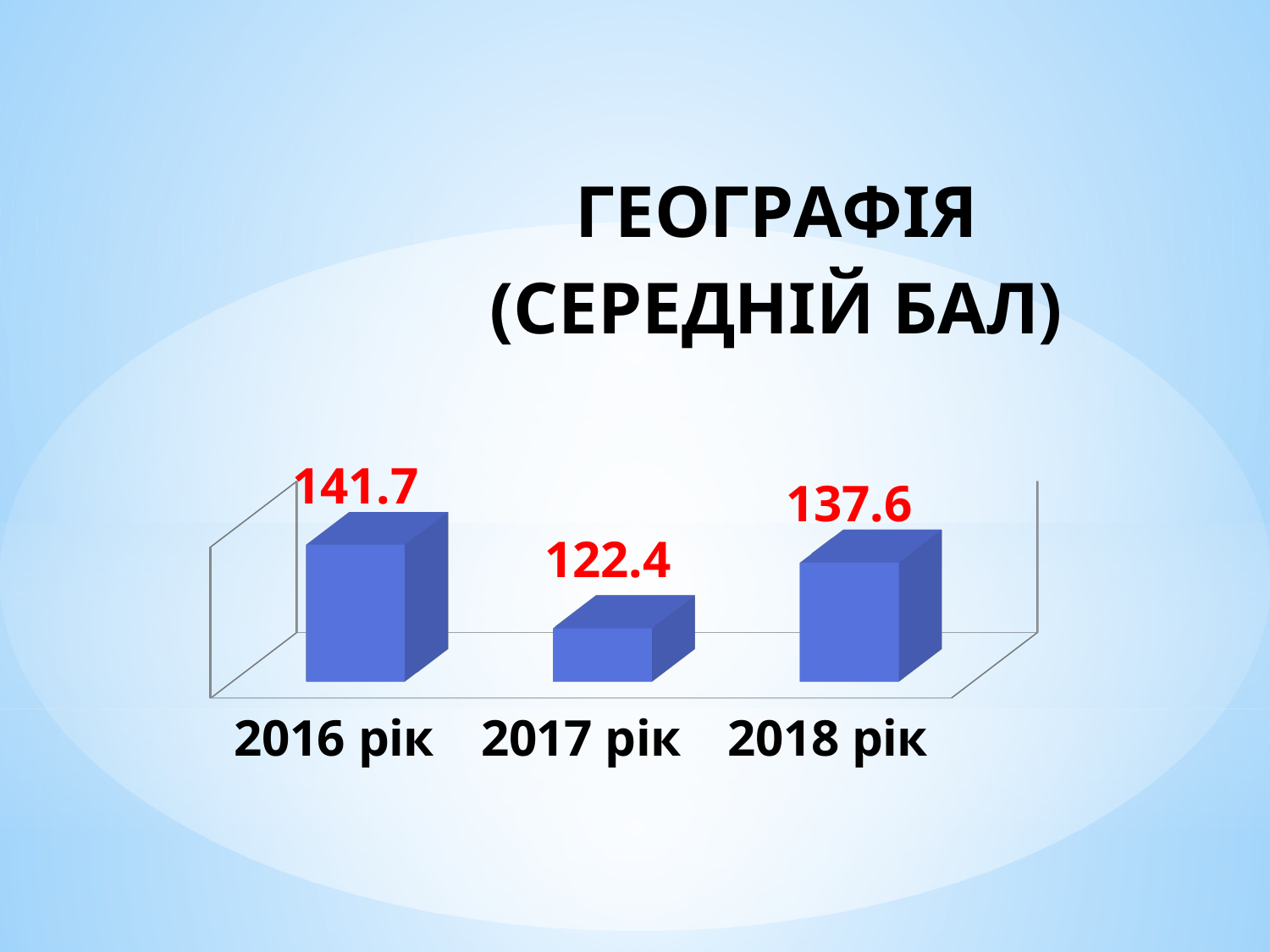
Which year has the highest average score? 2016 рік Which year has the lowest average score? 2017 рік What is the difference between the average scores for 2018 рік and 2017 рік? 15.2 What is the average score for 2016 рік? 141.7 Which is larger, the average score for 2016 рік or for 2018 рік? 2016 рік What is the average score for 2017 рік? 122.4 Does the average score rise or fall from 2016 рік to 2017 рік? Fall What kind of chart is shown on the slide? Bar chart What is the difference between the average scores for 2016 рік and 2017 рік? 19.3 What is the title of the chart? ГЕОГРАФІЯ (СЕРЕДНІЙ БАЛ) How many years are shown in the chart? 3 What is the average score for 2018 рік? 137.6